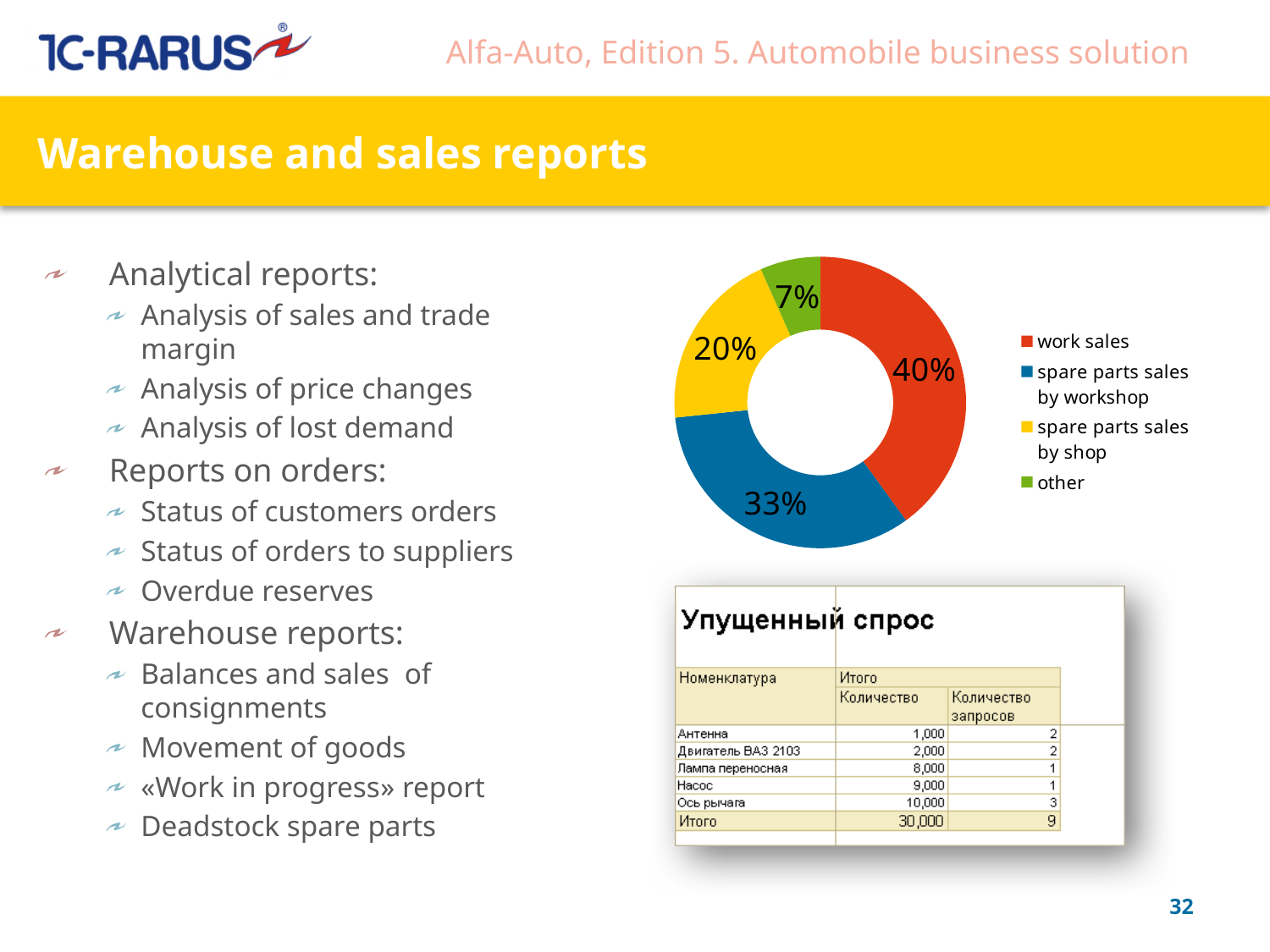
What share of the pie chart does work sales account for? 40% What share of the pie chart is spare parts sales by shop? 20% What share of the pie chart does the 'other' slice represent? 7% In the pie chart, which is larger: spare parts sales by workshop or spare parts sales by shop? spare parts sales by workshop Which category has the smallest slice in the pie chart? other How many slices does the pie chart have? 4 What colour is the 'other' slice in the pie chart? green What is the difference in percentage points between work sales and spare parts sales by shop in the pie chart? 20 What type of chart is shown on the slide? doughnut chart Which category has the largest slice in the pie chart? work sales What is the difference in percentage points between spare parts sales by workshop and other in the pie chart? 26